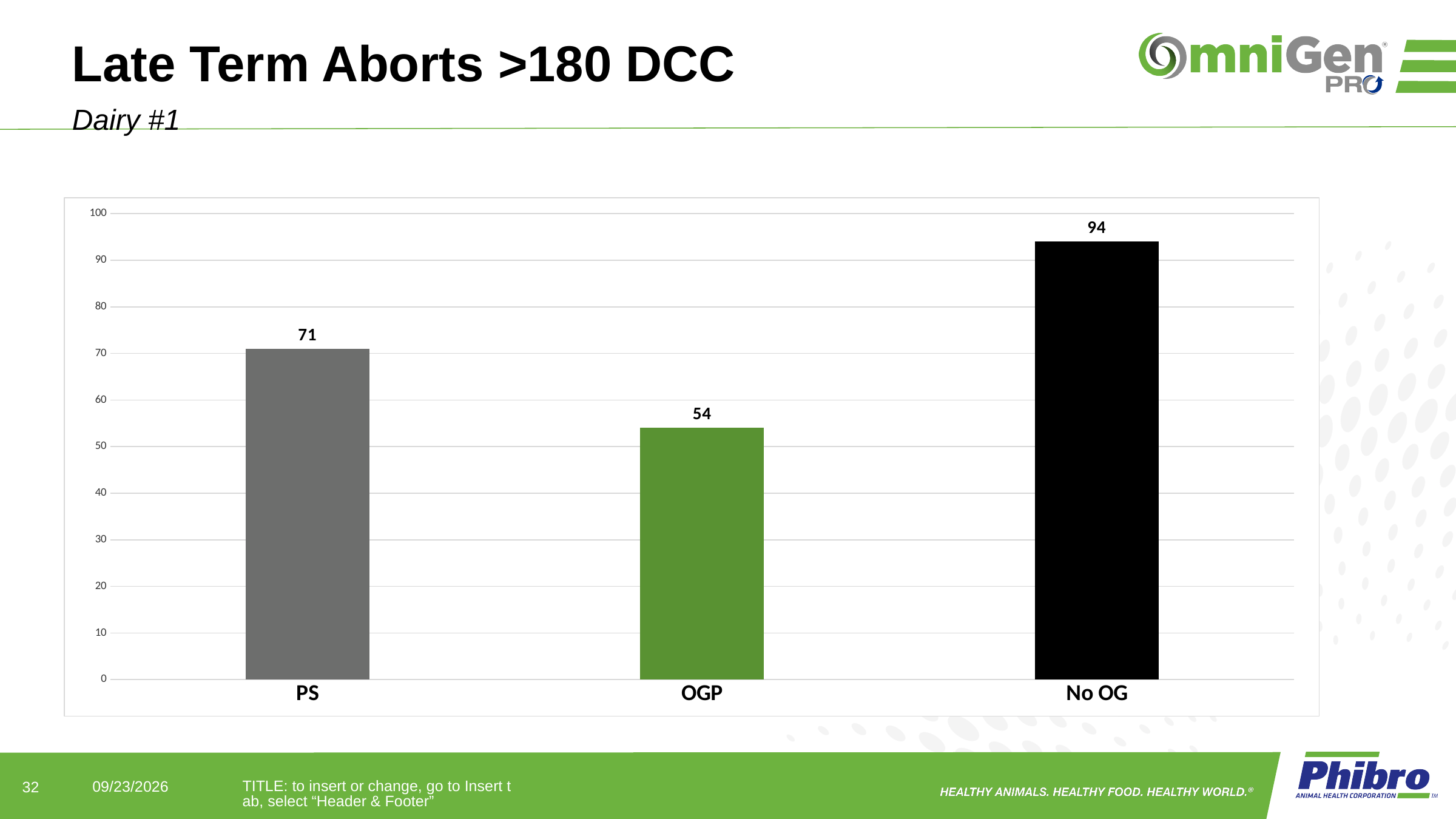
How many categories are shown on the x axis? 3 What kind of chart is shown on the slide? bar chart Is the value for No OG greater or less than 90? greater What is the value for PS? 71 What is the difference between the values for No OG and OGP? 40 Which is larger, the value for PS or the value for OGP? PS What is the value for OGP? 54 Which category has the highest value? No OG What is the value for No OG? 94 What colour is the bar for OGP? green What is the difference between the values for PS and OGP? 17 Which category has the lowest value? OGP